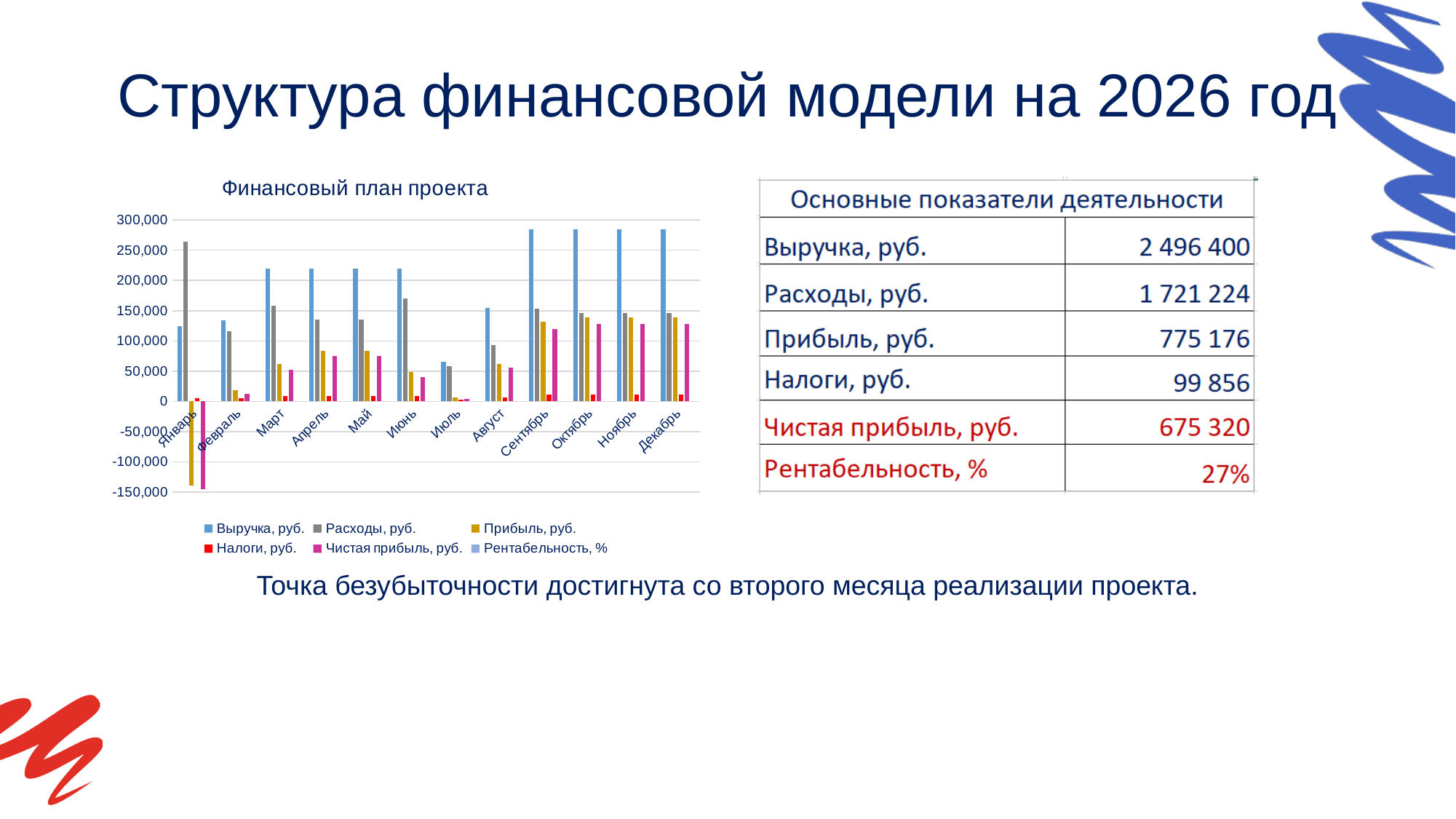
Which month has the highest value for Расходы, руб.? Январь How many months are shown on the x axis of the chart? 12 Does Выручка, руб. rise or fall from Январь to Апрель? Rise Which is larger: Выручка, руб. in Март or Выручка, руб. in Июль? Март What kind of chart is shown on the slide? Bar chart How many series does the chart legend list? 6 What is the title of the chart? Финансовый план проекта Which month has the lowest value for Выручка, руб.? Июль Is the value for Прибыль, руб. in Январь greater or less than -100,000? less Which month has the lowest value for Прибыль, руб.? Январь Is the value for Расходы, руб. in Январь greater or less than 200,000? greater Is the value for Выручка, руб. in Январь greater or less than 100,000? greater